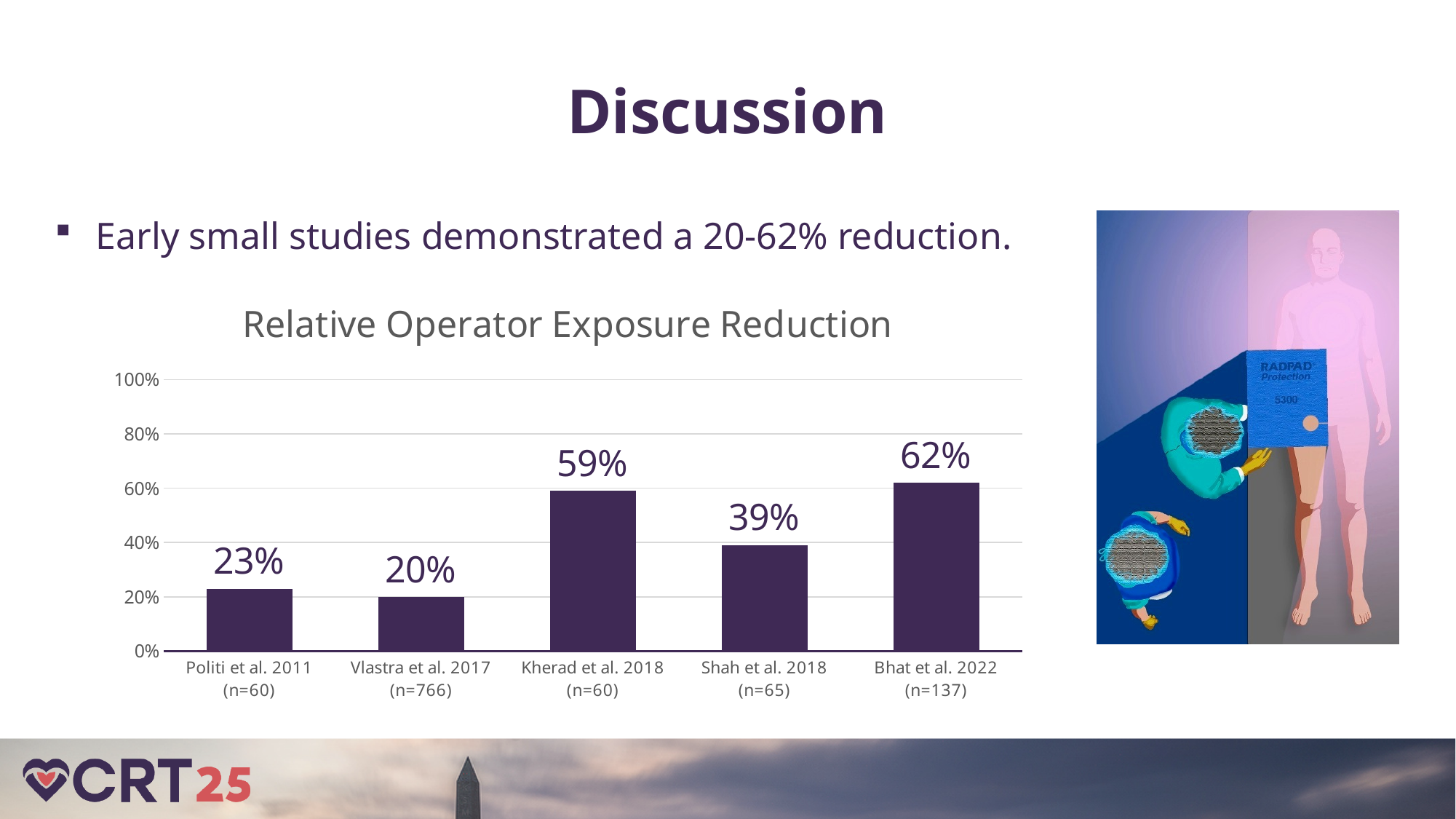
How many studies are shown in the chart? 5 Which has a larger exposure reduction, Politi et al. 2011 or Shah et al. 2018? Shah et al. 2018 Is the value for Kherad et al. 2018 greater or less than 40%? greater Which study shows the highest relative operator exposure reduction? Bhat et al. 2022 (n=137) What is the difference between the exposure reduction for Kherad et al. 2018 and Shah et al. 2018? 20% What is the relative operator exposure reduction reported for Kherad et al. 2018 (n=60)? 59% What is the relative operator exposure reduction reported for Shah et al. 2018 (n=65)? 39% What is the relative operator exposure reduction reported for Vlastra et al. 2017 (n=766)? 20% What is the title of the chart? Relative Operator Exposure Reduction Which study shows the lowest relative operator exposure reduction? Vlastra et al. 2017 (n=766) What is the difference between the exposure reduction for Bhat et al. 2022 and Politi et al. 2011? 39% What type of chart is used to show the relative operator exposure reduction? Bar chart